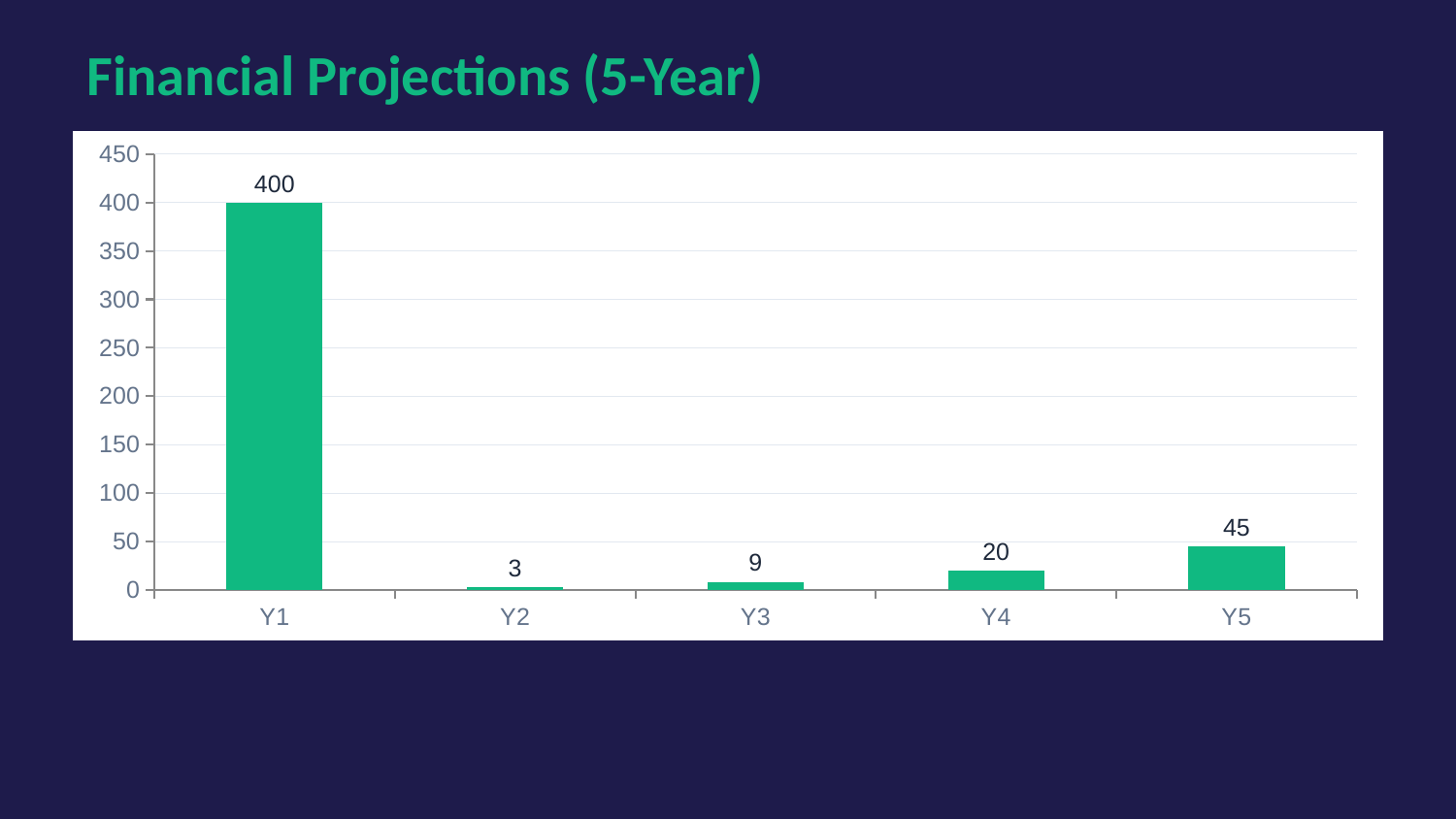
What kind of chart is shown on the slide? Bar chart What is the value for Y2? 3 What is the value for Y1? 400 How many categories are shown on the x axis? 5 Which category has the lowest value? Y2 What is the difference between the values for Y1 and Y5? 355 What is the value for Y4? 20 Which category has the highest value? Y1 Is the value for Y5 greater or less than 50? less What is the difference between the values for Y5 and Y4? 25 What is the value for Y5? 45 Which is larger, the value for Y3 or the value for Y4? Y4